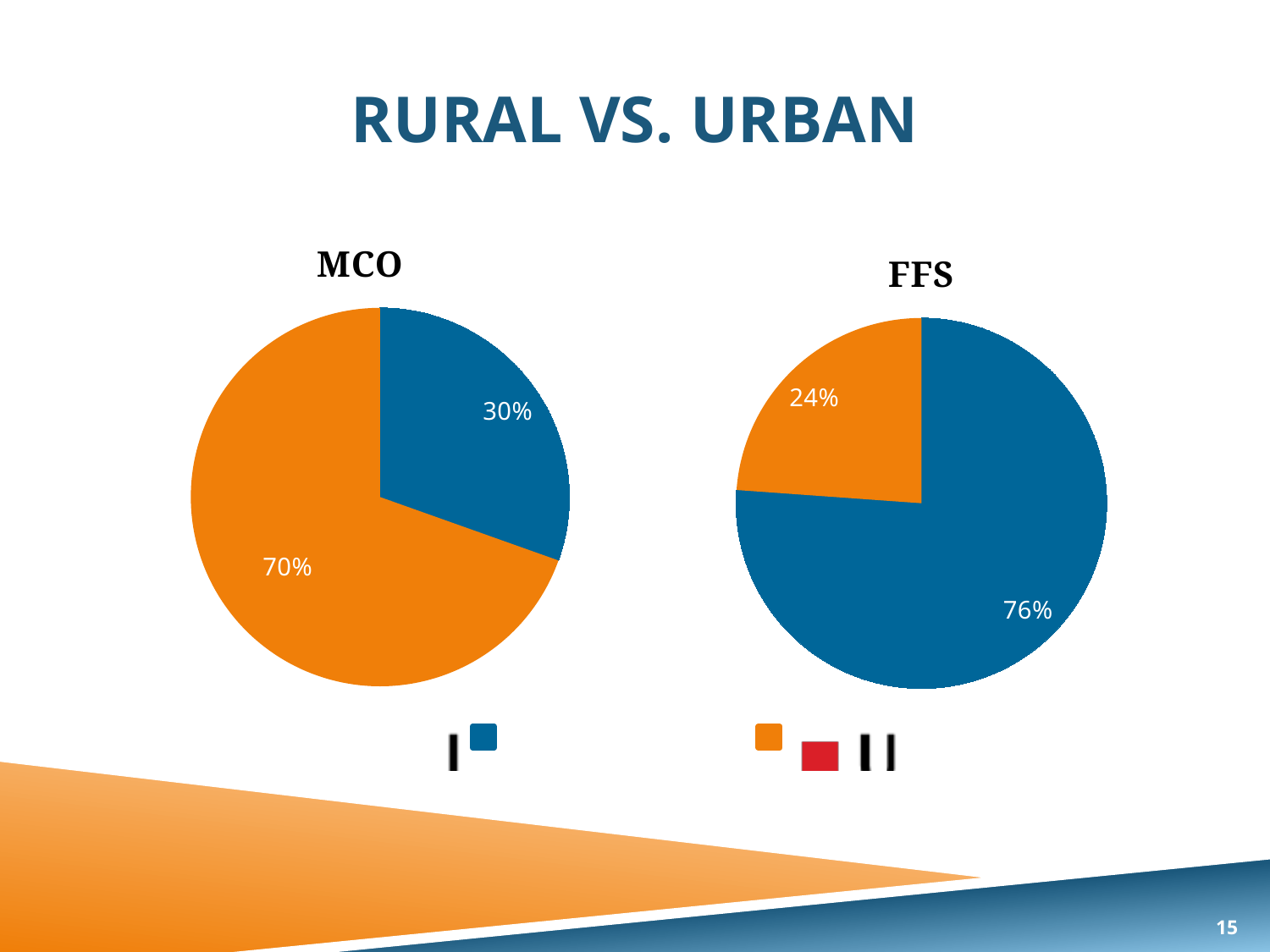
In the MCO pie chart, which colour slice is the largest? orange In the MCO pie chart, what is the difference between the orange slice and the blue slice? 40% How many slices does the FFS pie chart have? 2 In the FFS pie chart, which colour slice is the smallest? orange In the FFS pie chart, what percentage does the orange slice show? 24% What kind of chart is the MCO chart? pie chart In the MCO pie chart, what percentage does the orange slice show? 70% What is the title of the slide containing the two pie charts? RURAL VS. URBAN In the MCO pie chart, what percentage does the blue slice show? 30% In the FFS pie chart, what percentage does the blue slice show? 76% Which is larger: the blue slice in the MCO chart or the blue slice in the FFS chart? the blue slice in the FFS chart In the FFS pie chart, what is the difference between the blue slice and the orange slice? 52%